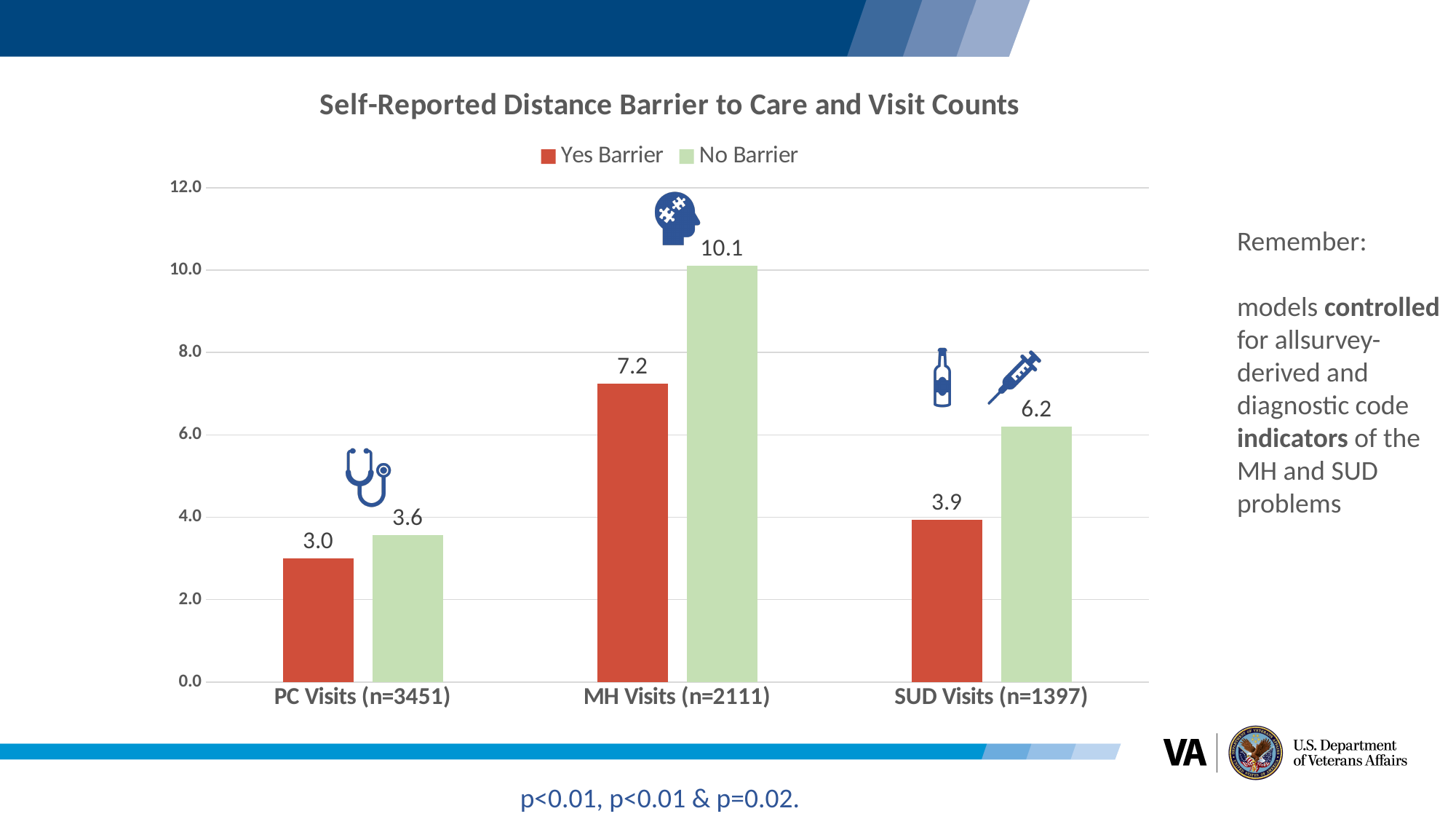
Which category has the lowest Yes Barrier value? PC Visits (n=3451) What is the Yes Barrier value for PC Visits (n=3451)? 3.0 Which category has the highest No Barrier value? MH Visits (n=2111) What is the Yes Barrier value for SUD Visits (n=1397)? 3.9 What is the No Barrier value for MH Visits (n=2111)? 10.1 How many series does the legend list? 2 What is the difference between the No Barrier and Yes Barrier values for MH Visits (n=2111)? 2.9 What is the title of the chart? Self-Reported Distance Barrier to Care and Visit Counts Which is larger, the Yes Barrier value for MH Visits (n=2111) or the No Barrier value for SUD Visits (n=1397)? Yes Barrier for MH Visits (n=2111) What is the difference between the No Barrier and Yes Barrier values for SUD Visits (n=1397)? 2.3 How many categories are shown on the x axis? 3 What kind of chart is shown on the slide? Bar chart